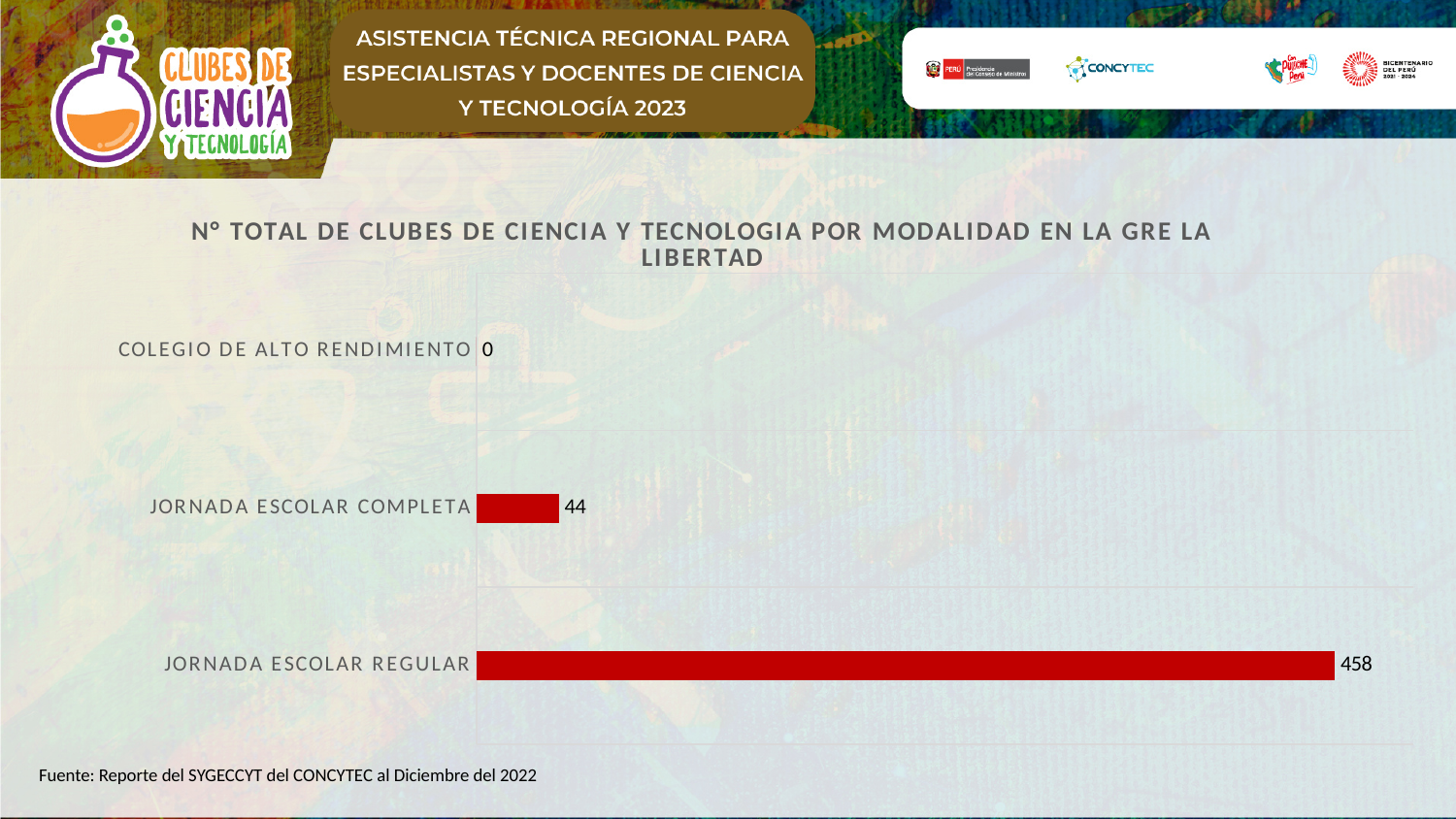
What kind of chart is shown on the slide? Bar chart Which category has the highest value? JORNADA ESCOLAR REGULAR Which category has the lowest value? COLEGIO DE ALTO RENDIMIENTO How many categories are shown in the chart? 3 Which is larger, the value for JORNADA ESCOLAR COMPLETA or the value for COLEGIO DE ALTO RENDIMIENTO? JORNADA ESCOLAR COMPLETA What is the value for COLEGIO DE ALTO RENDIMIENTO? 0 What is the total of all three values shown in the chart? 502 What colour are the bars in the chart? Red What is the value for JORNADA ESCOLAR REGULAR? 458 What is the value for JORNADA ESCOLAR COMPLETA? 44 What is the difference between the values for JORNADA ESCOLAR REGULAR and JORNADA ESCOLAR COMPLETA? 414 What is the title of the chart? N° TOTAL DE CLUBES DE CIENCIA Y TECNOLOGIA POR MODALIDAD EN LA GRE LA LIBERTAD